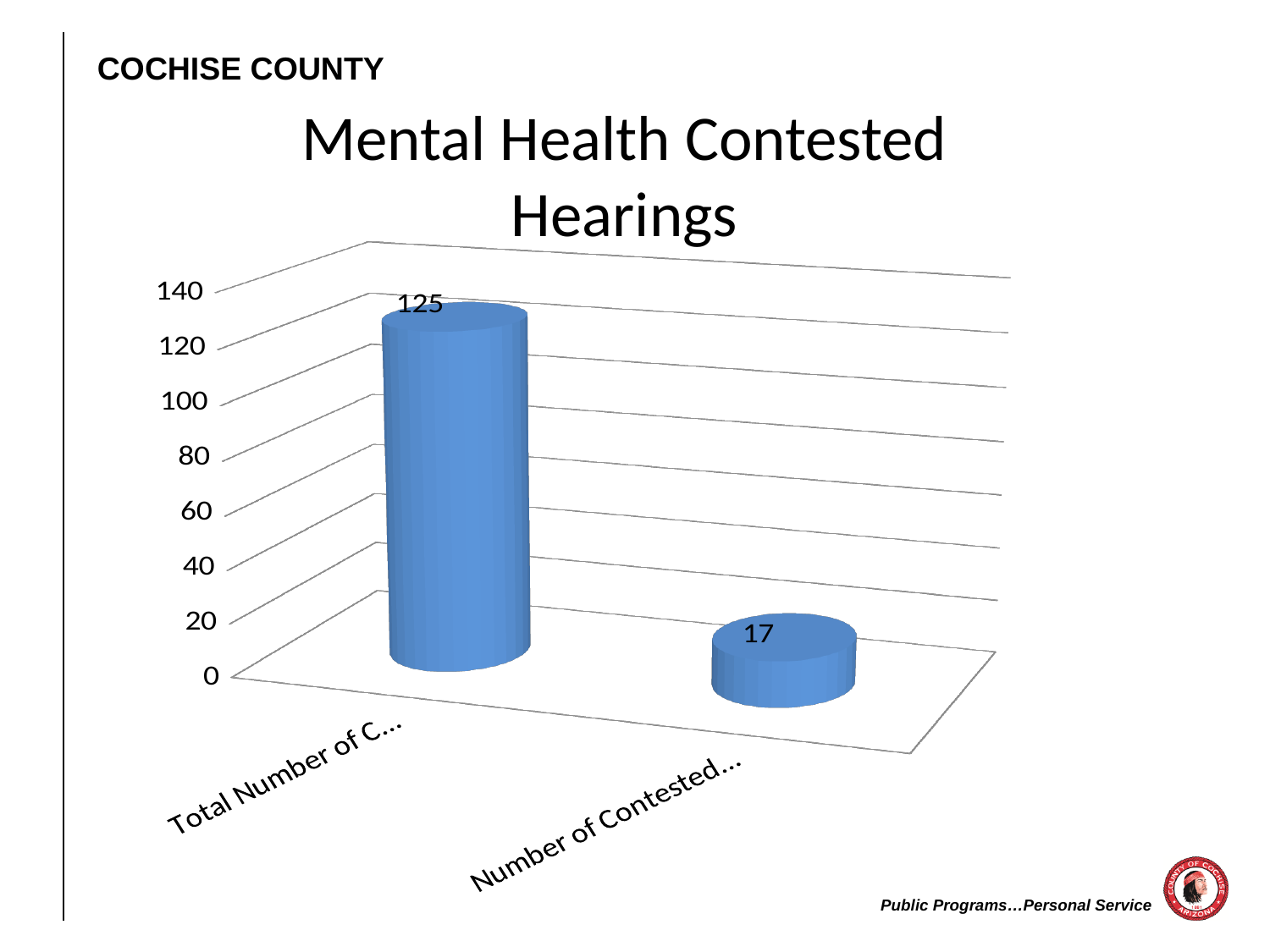
What is the value of the left bar, labelled "Total Number of C..."? 125 Which is larger: the value for "Total Number of C..." or the value for "Number of Contested..."? Total Number of C... What kind of chart is shown on the slide? Bar chart How many bars are plotted in the chart? 2 Which bar is the highest in the chart? Total Number of C... Which bar is the lowest in the chart? Number of Contested... What is the difference between the left bar (125) and the right bar (17)? 108 What is the value of the right bar, labelled "Number of Contested..."? 17 Is the value for "Number of Contested..." greater or less than 20? less Is the value for "Total Number of C..." greater or less than 120? greater What is the highest value shown on the vertical axis? 140 What is the title of the chart? Mental Health Contested Hearings